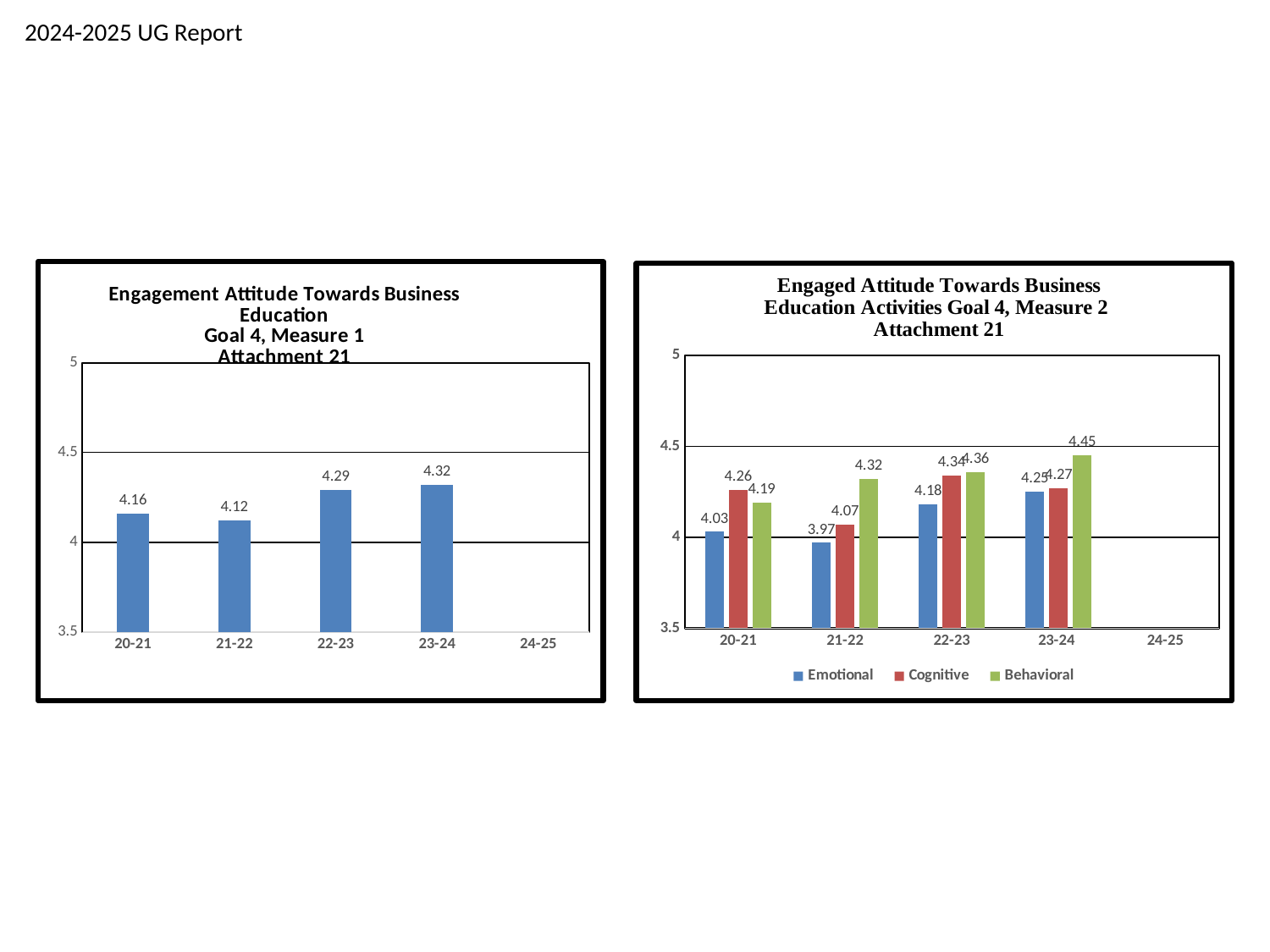
In the right chart (Goal 4, Measure 2), what is the Emotional value for 21-22? 3.97 In the right chart (Goal 4, Measure 2), what is the difference between the Behavioral and Emotional values for 21-22? 0.35 In the right chart (Goal 4, Measure 2), how many series does the legend list? 3 In the right chart (Goal 4, Measure 2), what is the Behavioral value for 23-24? 4.45 In the left chart (Goal 4, Measure 1), how many years have a bar plotted? 4 In the left chart (Goal 4, Measure 1), which year has the lowest value? 21-22 In the right chart (Goal 4, Measure 2), which is larger for 20-21: Cognitive or Behavioral? Cognitive What kind of chart is the left chart (Goal 4, Measure 1)? Bar chart In the left chart (Goal 4, Measure 1), what is the difference between the 23-24 value and the 20-21 value? 0.16 In the left chart (Goal 4, Measure 1), what is the value for 22-23? 4.29 In the right chart (Goal 4, Measure 2), which series is shown in green? Behavioral In the right chart (Goal 4, Measure 2), is the Emotional value for 21-22 greater or less than 4? less